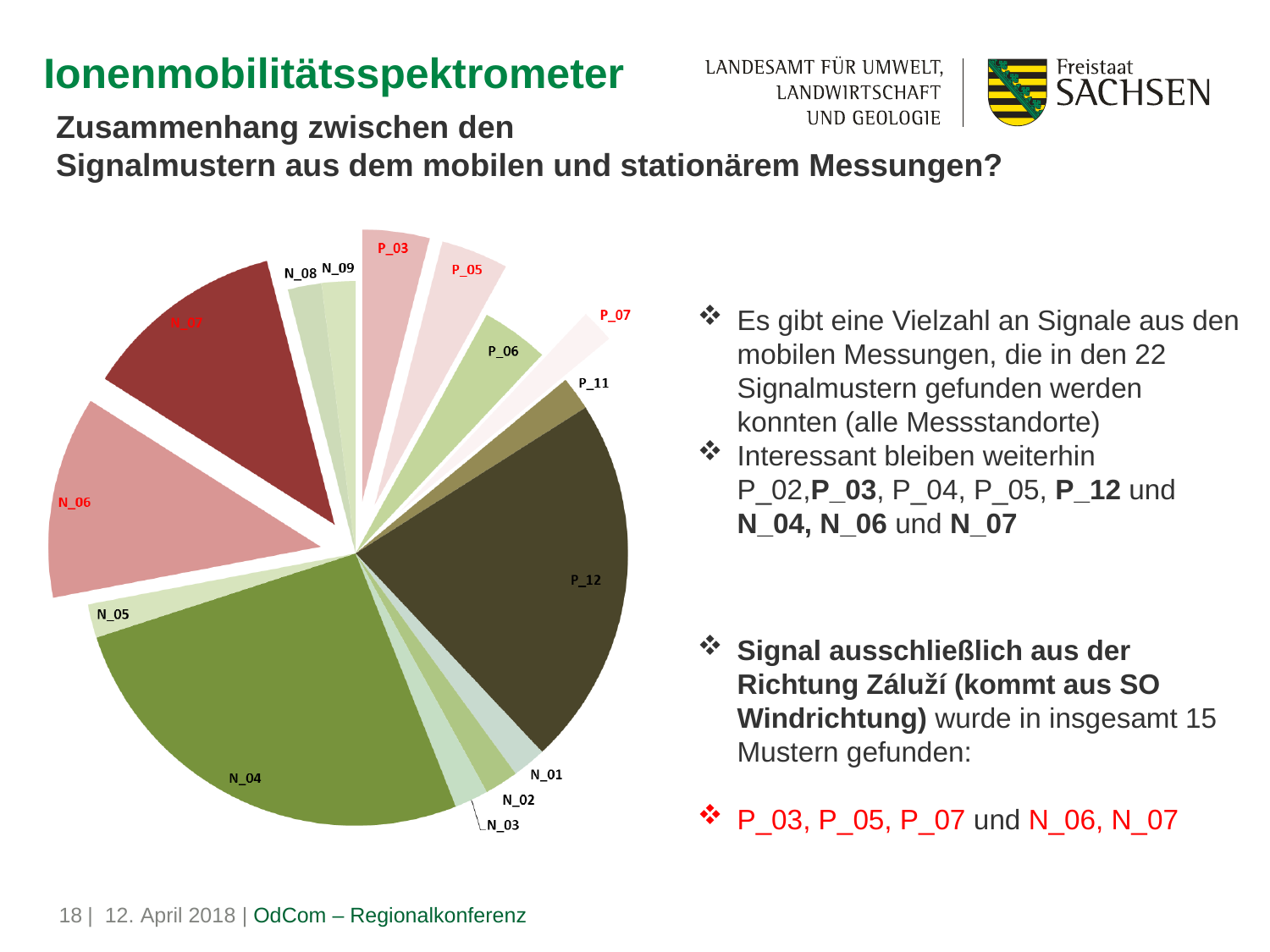
Which slice labels in the pie chart are printed in red? P_03, P_05, P_07, N_06, N_07 How many slices of the pie chart have labels starting with "N_"? 9 Which slice is larger in the pie chart, N_07 or N_09? N_07 Which slice is larger in the pie chart, P_12 or N_01? P_12 Which slice is larger in the pie chart, N_06 or N_08? N_06 What kind of chart is shown on the slide? pie chart Which slice of the pie chart is the largest? N_04 How many slices of the pie chart have labels starting with "P_"? 6